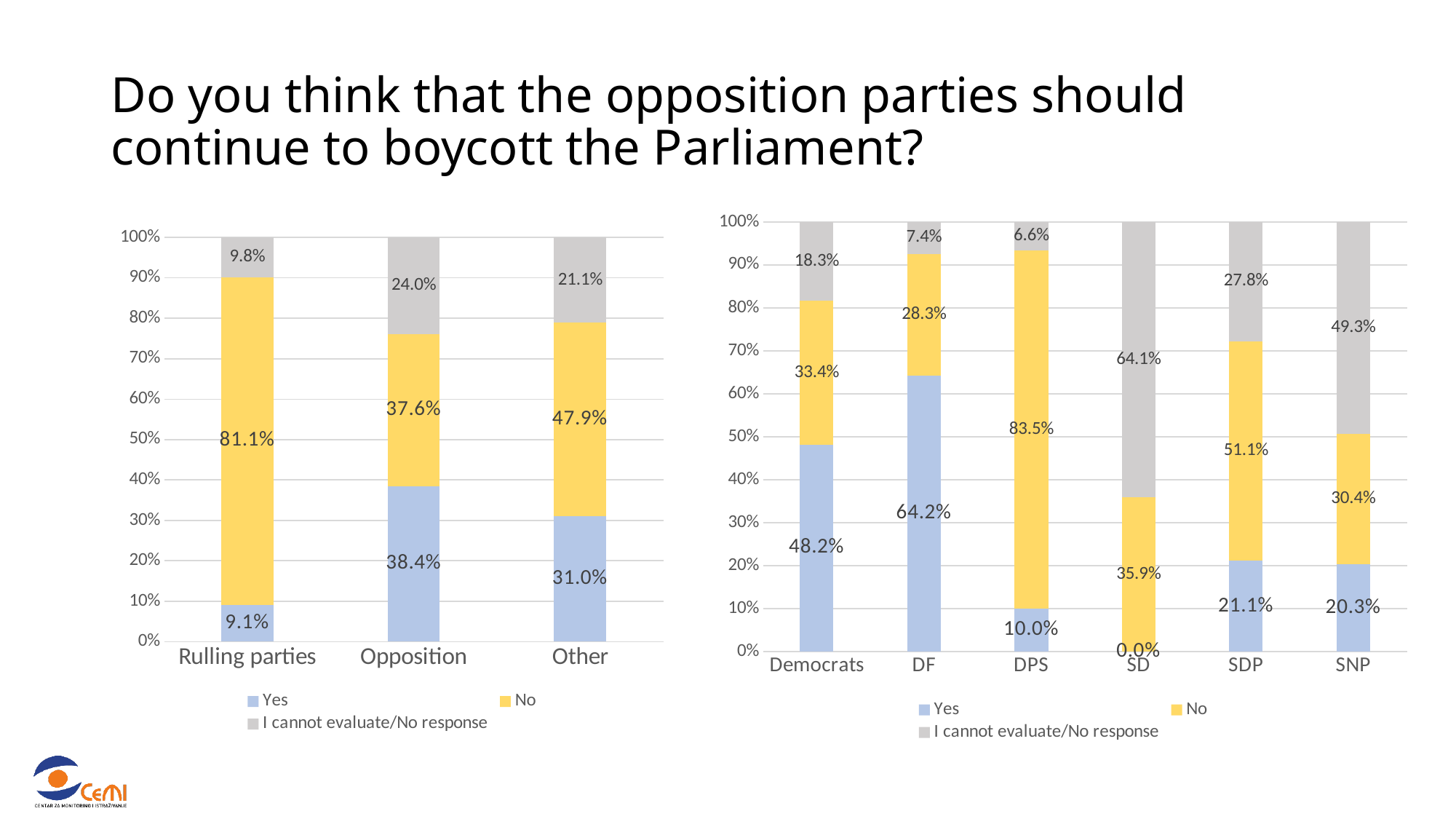
How many parties are shown on the x axis of the right chart? 6 In the left chart, what is the 'No' value for Rulling parties? 81.1% In the right chart, what is the 'Yes' value for DF? 64.2% In the left chart, which category has the highest 'I cannot evaluate/No response' value? Opposition In the right chart, which party has the highest 'I cannot evaluate/No response' value? SD In the right chart, what is the 'No' value for DPS? 83.5% How many series does the legend of the left chart list? 3 In the left chart, what is the 'Yes' value for Opposition? 38.4% In the right chart, is the 'No' value larger for SDP or SNP? SDP What type of chart is the right chart? Stacked bar chart In the right chart, which party has the lowest 'Yes' value? SD In the left chart, what is the difference between the 'Yes' values for Opposition and Rulling parties? 29.3%